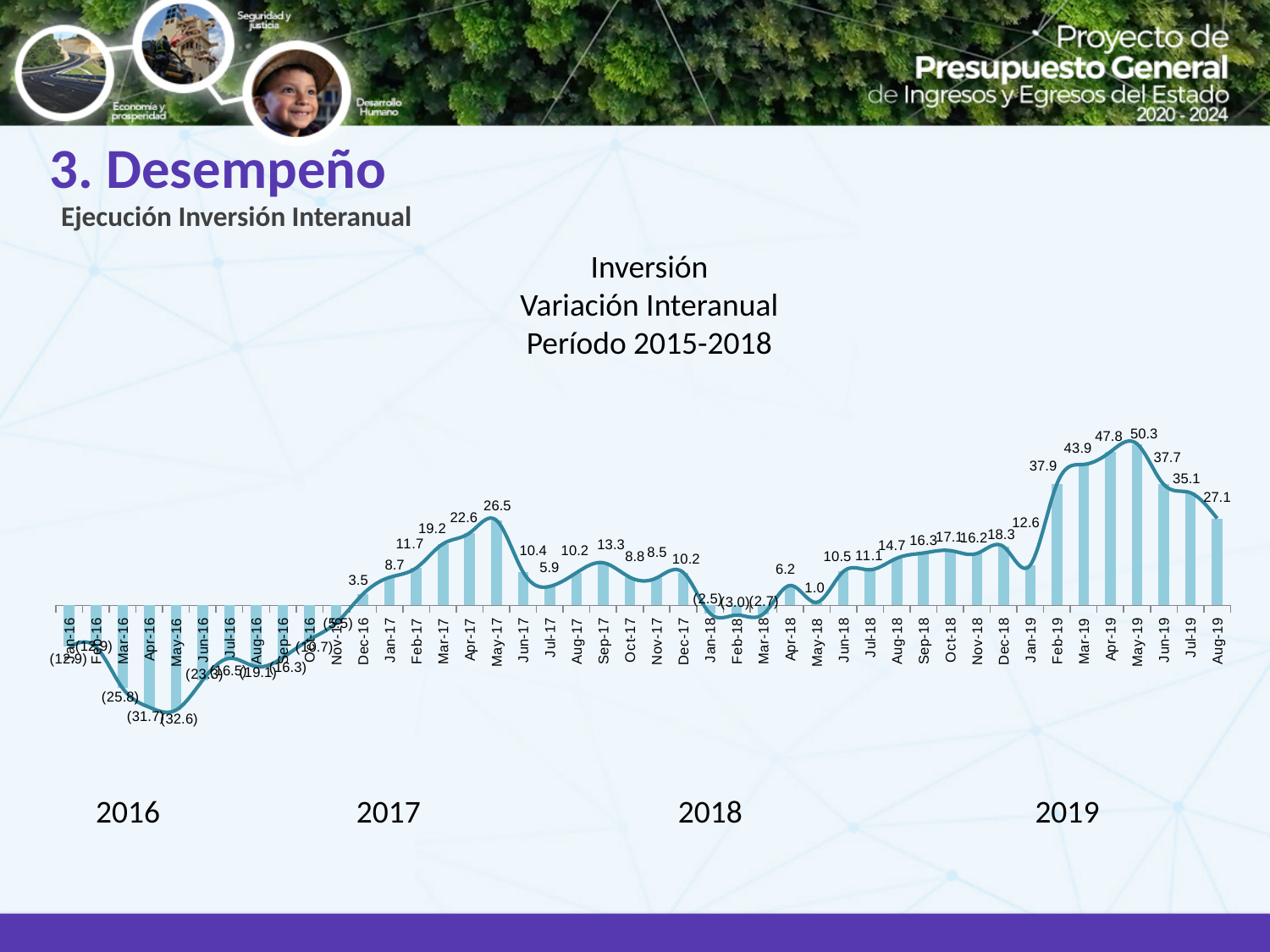
Do the values rise or fall from Jan-19 to May-19? Rise What kind of chart is this? Bar chart with a line overlay Which month has the highest value? May-19 What is the value for May-19? 50.3 How many monthly data points are plotted, from Jan-16 to Aug-19? 44 Which month has the lowest value? May-16 Which is larger, the value for Mar-17 or the value for Sep-17? Mar-17 What is the value for Mar-16? (25.8) What is the value for May-17? 26.5 What is the title of the chart? Inversión Variación Interanual Período 2015-2018 What is the difference between the values for May-19 and Apr-19? 2.5 What is the value for Dec-16? 3.5